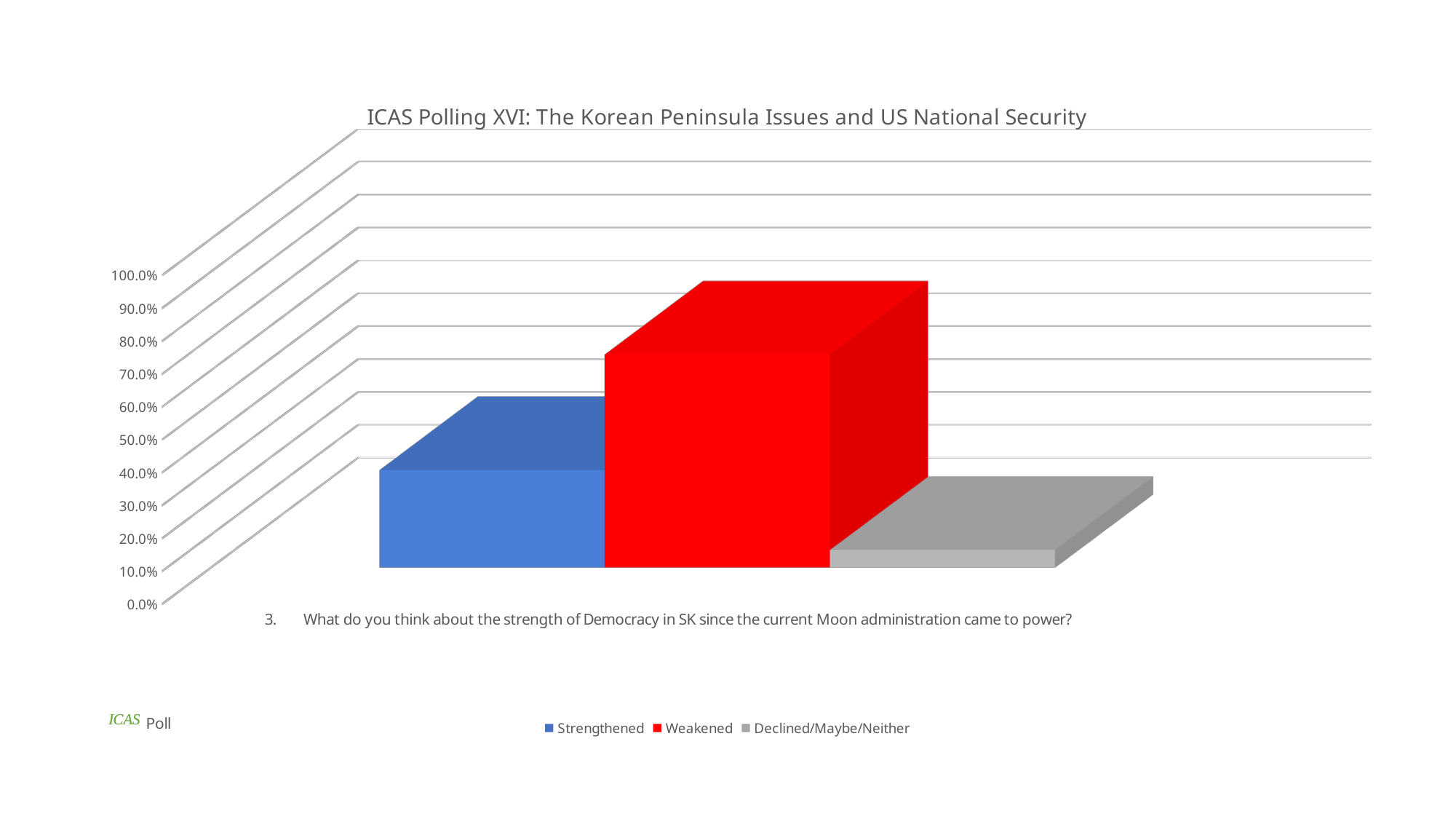
Which is larger, the value for Strengthened or the value for Weakened? Weakened What kind of chart is shown on the slide? bar chart What is the title of the chart? ICAS Polling XVI: The Korean Peninsula Issues and US National Security How many categories are shown on the x axis? 1 Which series has the highest value? Weakened Is the value for Weakened greater or less than 50.0%? greater Which series has the lowest value? Declined/Maybe/Neither How many series does the legend list? 3 Is the value for Strengthened greater or less than 50.0%? less Is the value for Declined/Maybe/Neither greater or less than 20.0%? less Which series is shown in red? Weakened Which is larger, the value for Strengthened or the value for Declined/Maybe/Neither? Strengthened